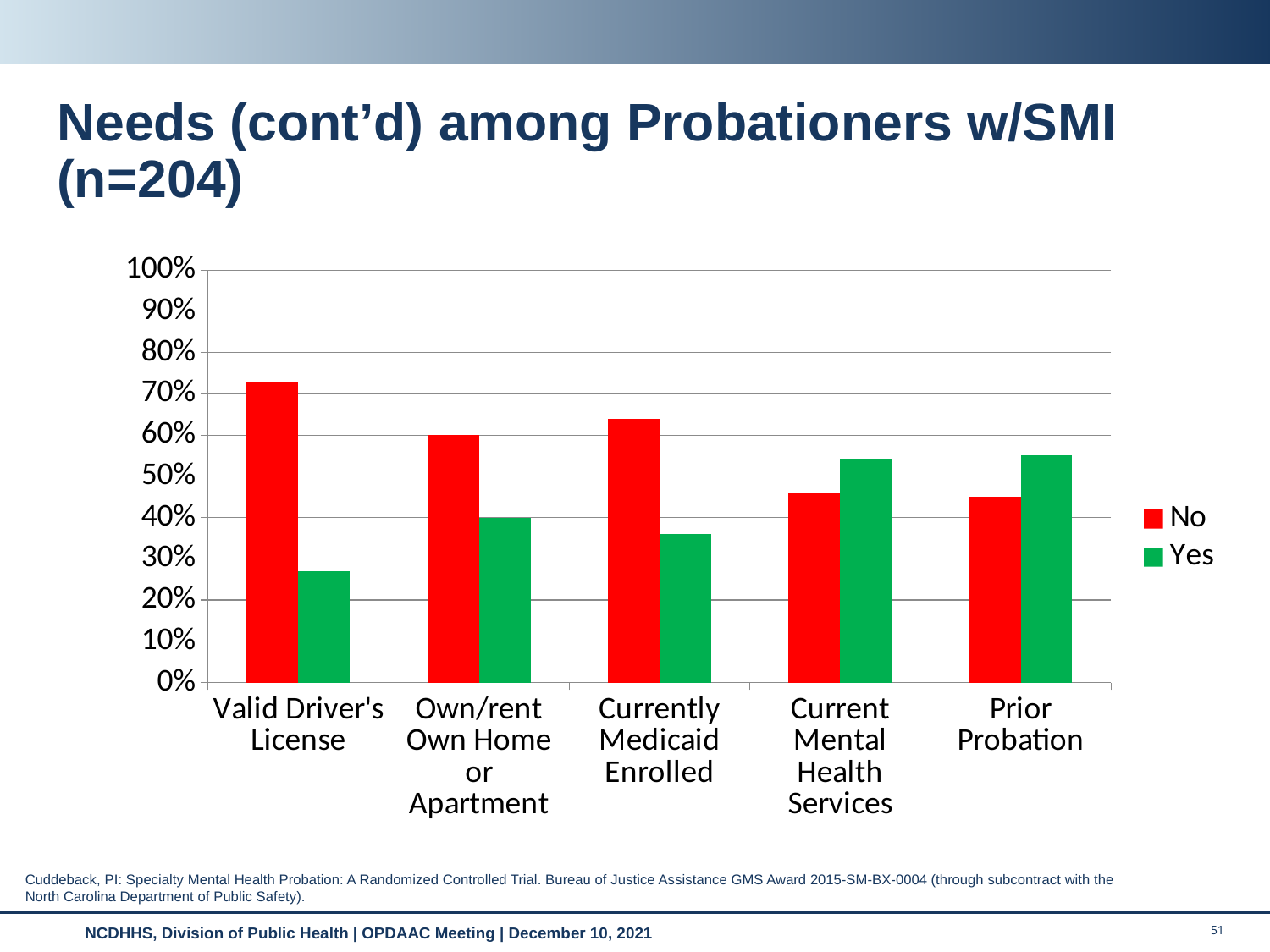
Is the 'No' value for Prior Probation greater or less than 50%? less How many series does the chart's legend list? 2 Is the 'Yes' value for Current Mental Health Services greater or less than 50%? greater Which colour represents the 'Yes' series in the chart? green Is the 'Yes' value for Valid Driver's License greater or less than 30%? less For Current Mental Health Services, which is larger, the 'No' value or the 'Yes' value? Yes Which category has the lowest 'Yes' value? Valid Driver's License Which category has the highest 'No' value? Valid Driver's License What kind of chart is shown on the slide? bar chart How many categories are shown on the x axis of the chart? 5